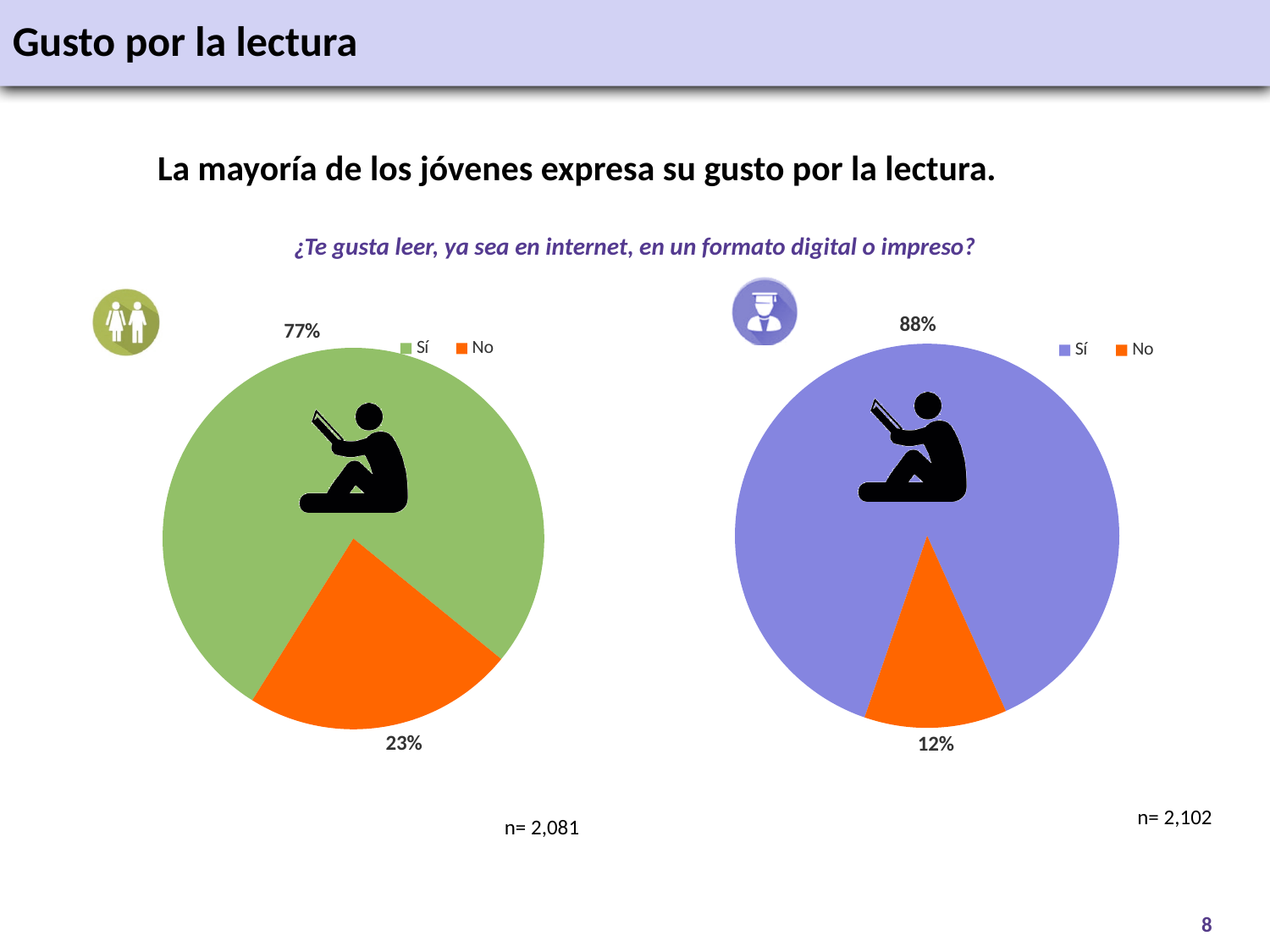
In the left pie chart, what percentage answered Sí? 77% Is the Sí share larger in the left pie chart or the right pie chart? right pie chart What type of chart is used on this slide? pie chart How many series does the legend of the left pie chart list? 2 In the left pie chart, what is the difference in percentage points between Sí and No? 54 In the left pie chart, which category has the largest share? Sí What colour represents No in both pie charts? orange In the left pie chart, what percentage answered No? 23% In the right pie chart, which category has the smallest share? No How many slices does the right pie chart have? 2 In the right pie chart, what percentage answered No? 12% In the right pie chart, what percentage answered Sí? 88%